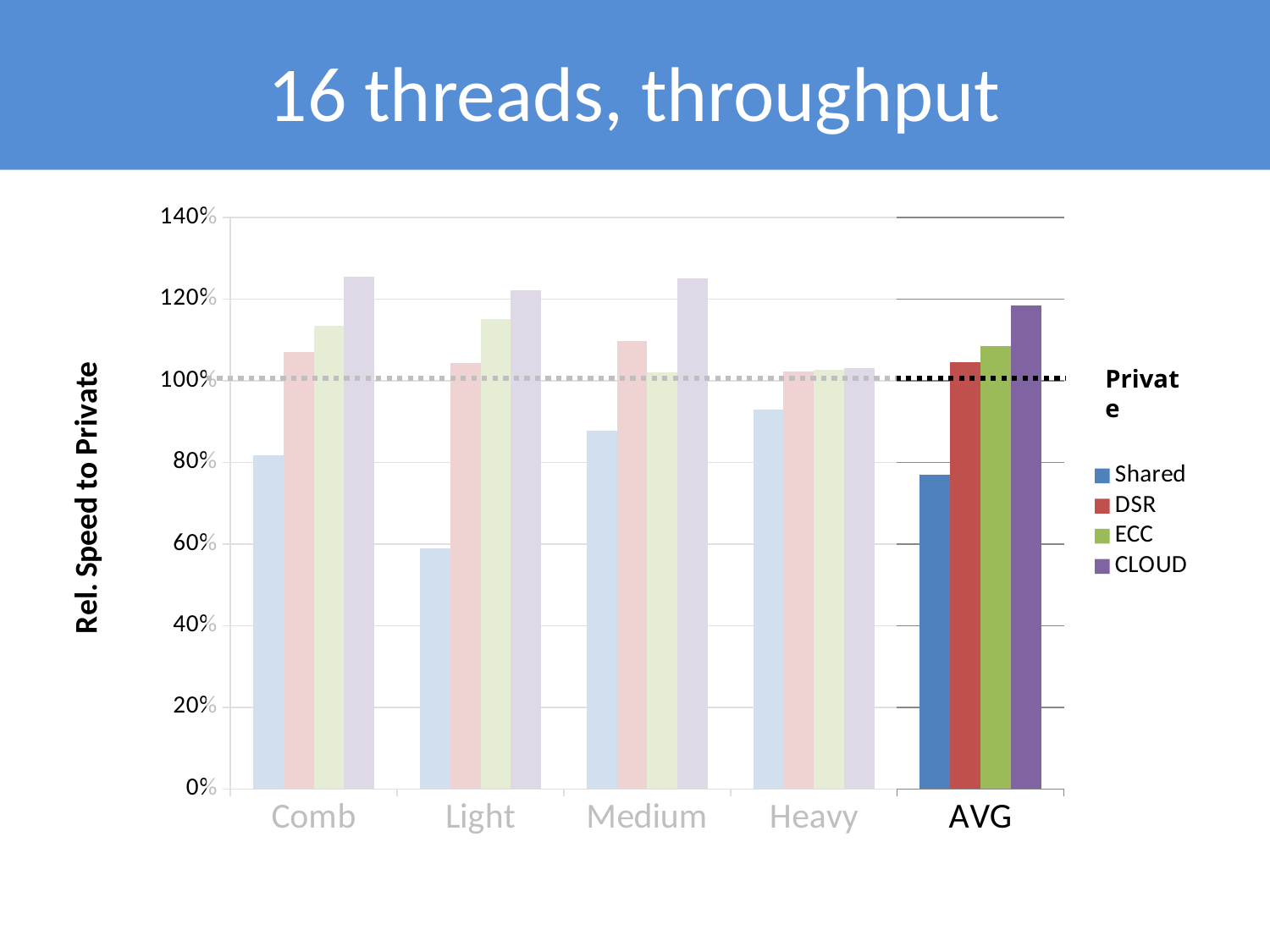
In the AVG category, which series has the highest bar? CLOUD How many bar series does the legend list? 4 Is the CLOUD value for Comb greater or less than 120%? greater Which is larger, the ECC value for Light or the ECC value for Medium? Light In the AVG category, which series has the lowest bar? Shared What kind of chart is shown on the slide? bar chart What is the label on the vertical axis? Rel. Speed to Private Is the Shared value for AVG greater or less than 80%? less How many categories are shown on the x axis? 5 Is the Shared value for Light greater or less than 80%? less For the Shared series, which category has the lowest bar? Light What is the title of the slide's chart? 16 threads, throughput